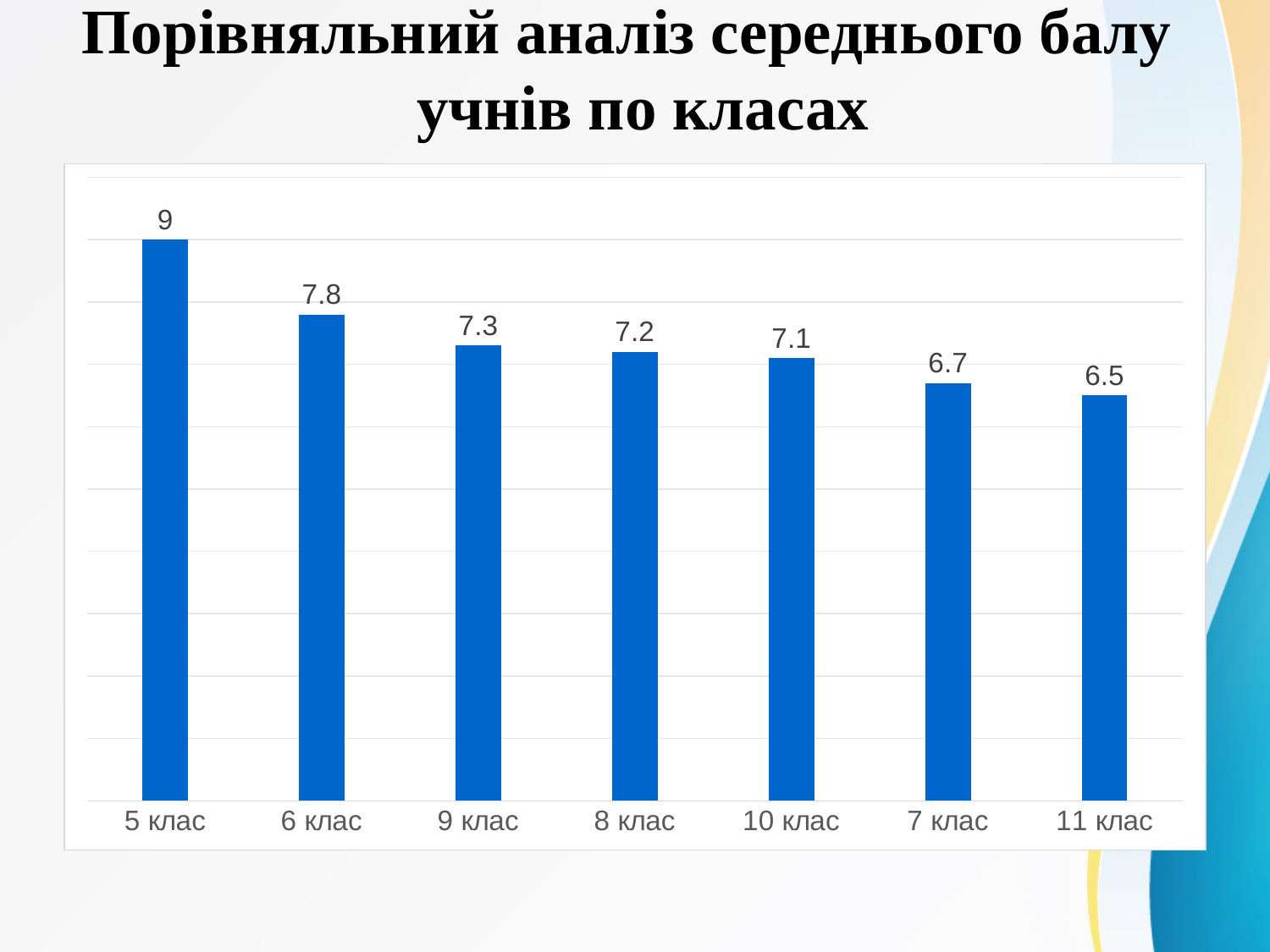
Do the values rise or fall from left to right along the x axis? Fall What type of chart is shown on the slide? Bar chart Which class has the highest average score? 5 клас How many classes are shown in the chart? 7 Which class has the lowest average score? 11 клас What is the average score for 10 клас? 7.1 What is the difference between the average scores of 5 клас and 6 клас? 1.2 What is the average score for 5 клас? 9 What is the average score for 11 клас? 6.5 Which has a higher average score, 8 клас or 7 клас? 8 клас What is the title of the slide? Порівняльний аналіз середнього балу учнів по класах What is the difference between the average scores of 9 клас and 7 клас? 0.6